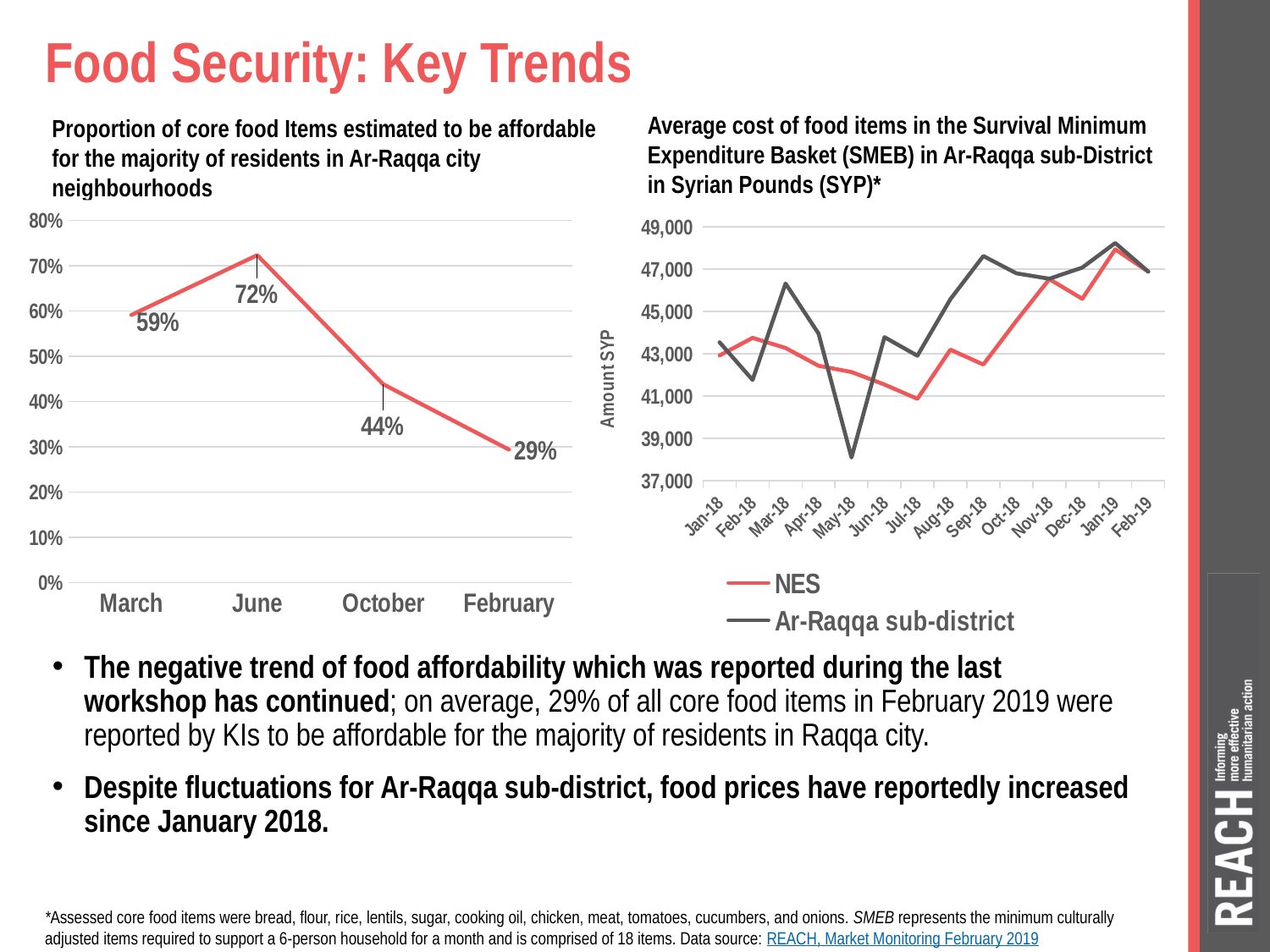
In the left chart (Proportion of core food items estimated to be affordable), how many months are plotted? 4 In the left chart (Proportion of core food items estimated to be affordable), do the values rise or fall from June to February? fall In the right chart (Average cost of food items in the SMEB), how many series does the legend list? 2 What kind of chart is the right chart (Average cost of food items in the SMEB)? line chart In the right chart (Average cost of food items in the SMEB), which series has the larger value in May-18, NES or Ar-Raqqa sub-district? NES In the right chart (Average cost of food items in the SMEB), is the Ar-Raqqa sub-district value for May-18 greater or less than 39,000? less In the left chart (Proportion of core food items estimated to be affordable), what is the difference between the June and October values? 28% In the left chart (Proportion of core food items estimated to be affordable), which month has the lowest value? February In the right chart (Average cost of food items in the SMEB), is the NES value for Jan-19 greater or less than 47,000? greater In the left chart (Proportion of core food items estimated to be affordable), which month has the highest value? June In the left chart (Proportion of core food items estimated to be affordable), what is the value for June? 72% In the left chart (Proportion of core food items estimated to be affordable), what is the value for February? 29%